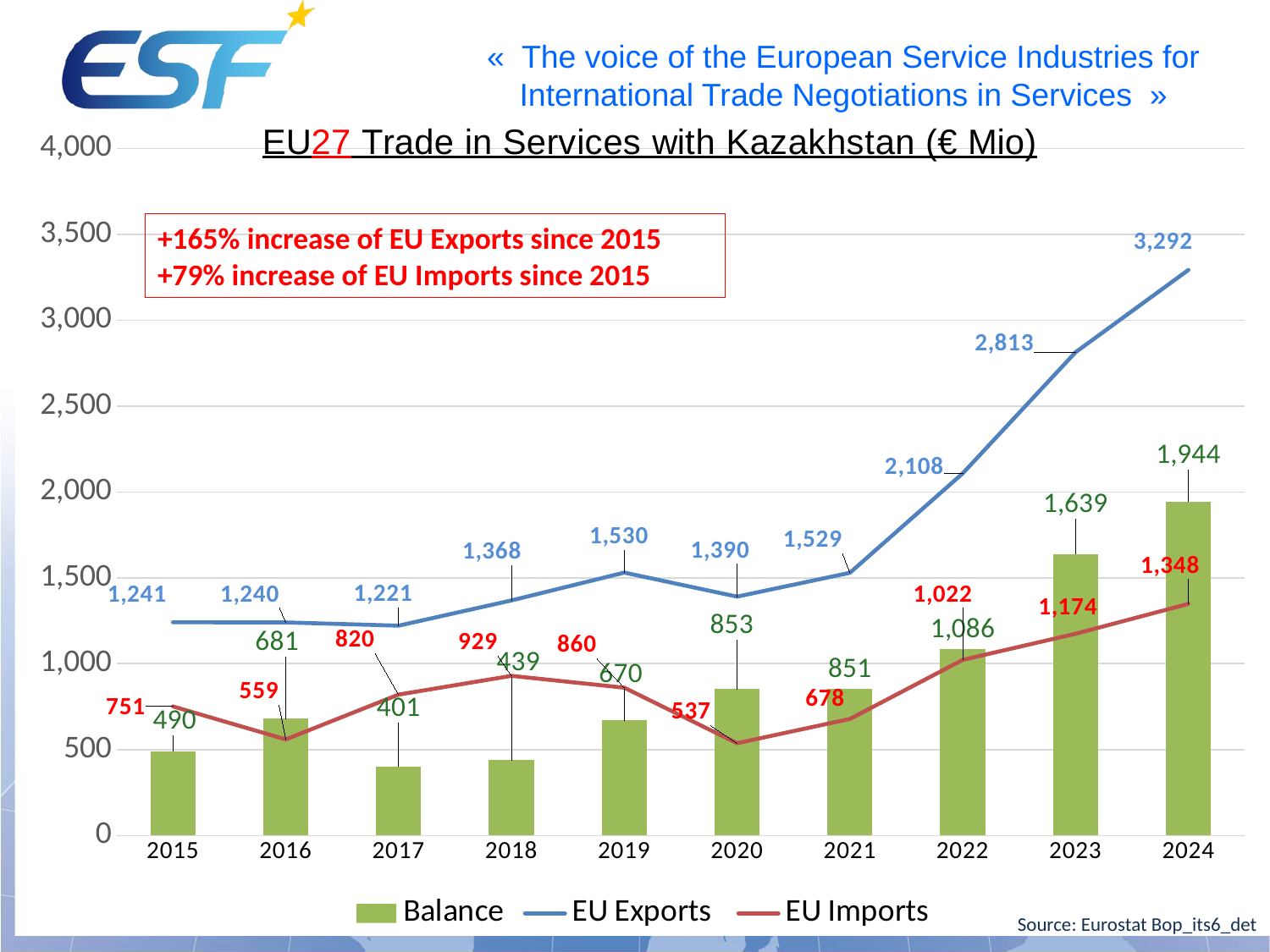
Do EU Exports rise or fall from 2021 to 2024? Rise How many series does the legend list? 3 What is the difference between EU Exports in 2023 and EU Exports in 2022? 705 What is the value of EU Imports in 2018? 929 How many years are shown on the x axis? 10 What is the title of the chart? EU27 Trade in Services with Kazakhstan (€ Mio) What is the Balance value for 2020? 853 In which year are EU Imports highest? 2024 In which year is the Balance lowest? 2017 What is the value of EU Exports in 2024? 3,292 Which is larger, EU Imports in 2015 or EU Imports in 2016? EU Imports in 2015 What kind of chart is used to show the Balance series? Bar chart